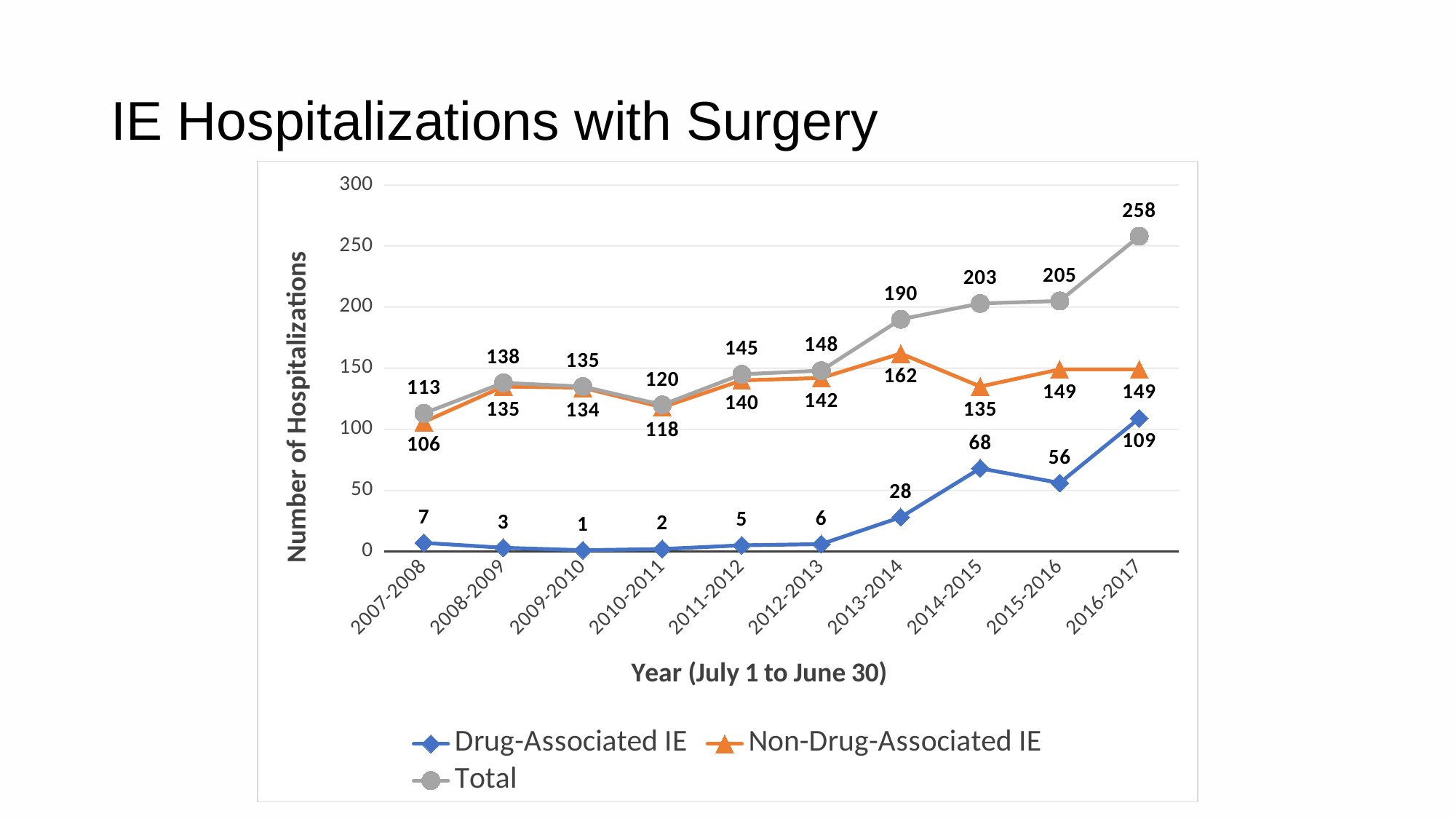
What is the difference between the Total values for 2016-2017 and 2015-2016? 53 In which year is the Drug-Associated IE value lowest? 2009-2010 What is the Total value for 2016-2017? 258 What kind of chart is shown on the slide? Line chart How many series does the legend list? 3 What is the Non-Drug-Associated IE value for 2013-2014? 162 Which is larger, the Drug-Associated IE value for 2014-2015 or for 2015-2016? 2014-2015 What is the Drug-Associated IE value for 2014-2015? 68 Does the Drug-Associated IE series rise or fall from 2012-2013 to 2016-2017? Rise In which year is the Total value highest? 2016-2017 How many years are shown on the x axis? 10 What is the title of the y axis? Number of Hospitalizations